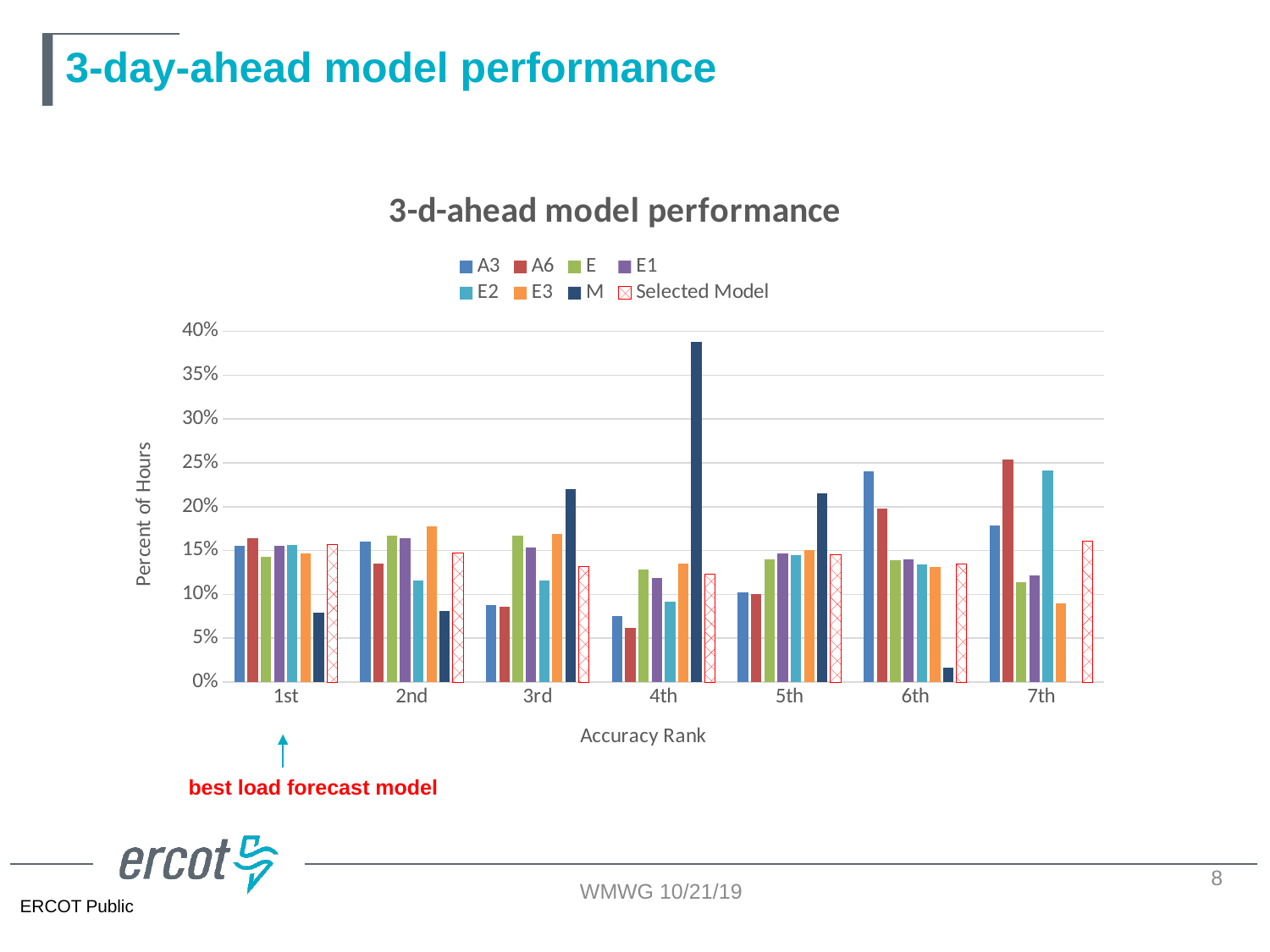
How many series does the legend list? 8 Is the value for M at the 1st accuracy rank greater or less than 10%? less What kind of chart is shown on the slide? bar chart Is the value for A3 at the 6th accuracy rank greater or less than 20%? greater Is the value for M at the 4th accuracy rank greater or less than 35%? greater Which is larger: the value for M at the 4th rank or the value for M at the 5th rank? M at the 4th rank Which series has the lowest value at the 6th accuracy rank? M How many accuracy rank categories are shown on the x axis? 7 Which series has the highest value at the 4th accuracy rank? M What is the label of the y axis? Percent of Hours Which is larger: the value for A3 at the 6th rank or the value for A3 at the 1st rank? A3 at the 6th rank